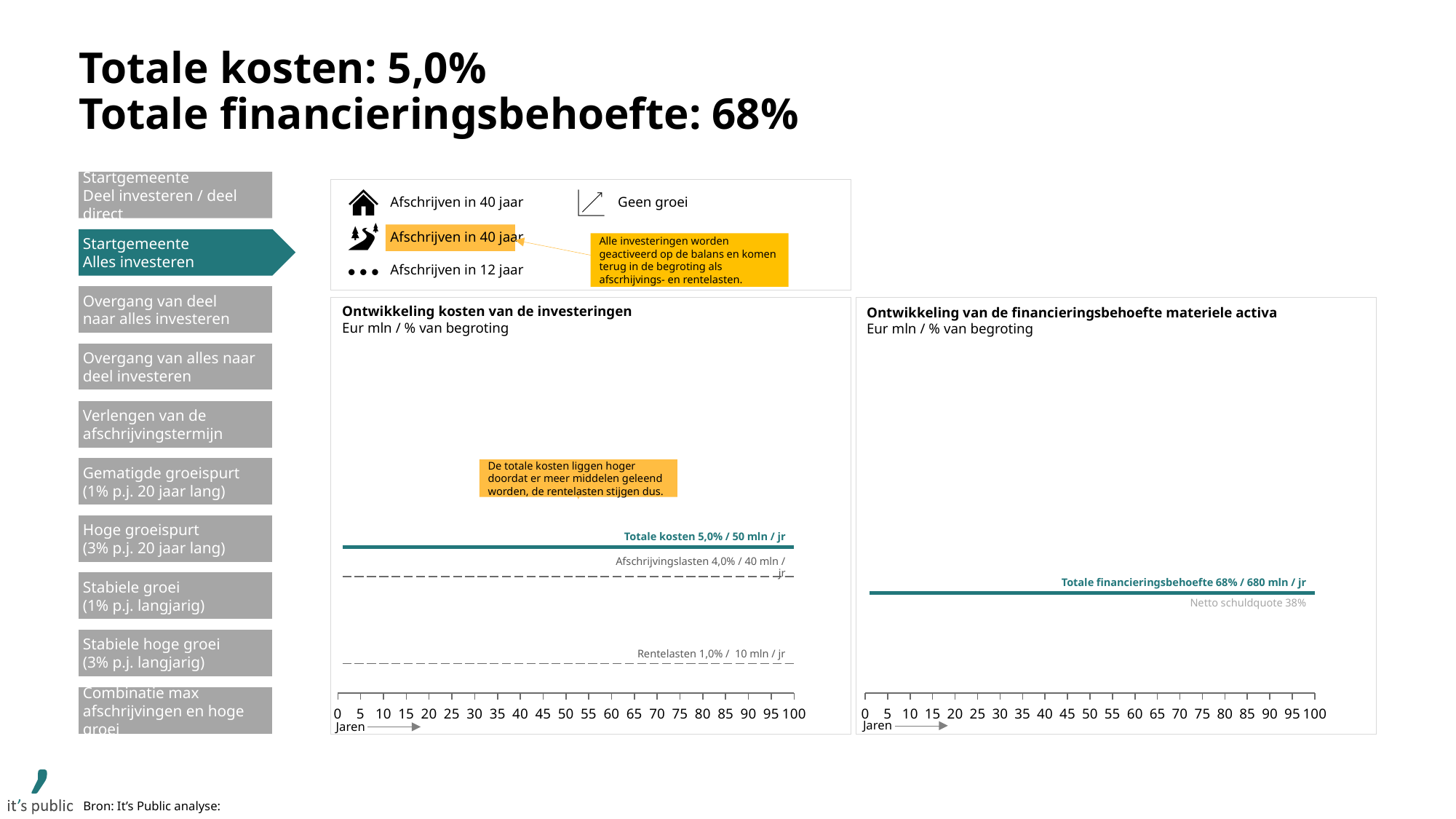
In the chart 'Ontwikkeling van de financieringsbehoefte materiele activa', what percentage is given for Netto schuldquote? 38% In the chart 'Ontwikkeling kosten van de investeringen', what value is labelled for Afschrijvingslasten? 4,0% / 40 mln / jr In the chart 'Ontwikkeling kosten van de investeringen', which of the three labelled lines has the lowest value? Rentelasten In the chart 'Ontwikkeling kosten van de investeringen', what is the difference in percentage points between Totale kosten and Afschrijvingslasten? 1,0% In the chart 'Ontwikkeling van de financieringsbehoefte materiele activa', what value is labelled for Totale financieringsbehoefte? 68% / 680 mln / jr In the chart 'Ontwikkeling kosten van de investeringen', what is the highest value shown on the x axis (Jaren)? 100 In the chart 'Ontwikkeling kosten van de investeringen', what value is labelled for Rentelasten? 1,0% / 10 mln / jr In the chart 'Ontwikkeling kosten van de investeringen', do the values rise, fall or stay constant over the years on the x axis? Stay constant In the chart 'Ontwikkeling kosten van de investeringen', what value is labelled for Totale kosten? 5,0% / 50 mln / jr What kind of chart is 'Ontwikkeling van de financieringsbehoefte materiele activa'? Line chart In the chart 'Ontwikkeling kosten van de investeringen', which is larger: Afschrijvingslasten or Rentelasten? Afschrijvingslasten In the chart 'Ontwikkeling kosten van de investeringen', which of the three labelled lines has the highest value? Totale kosten